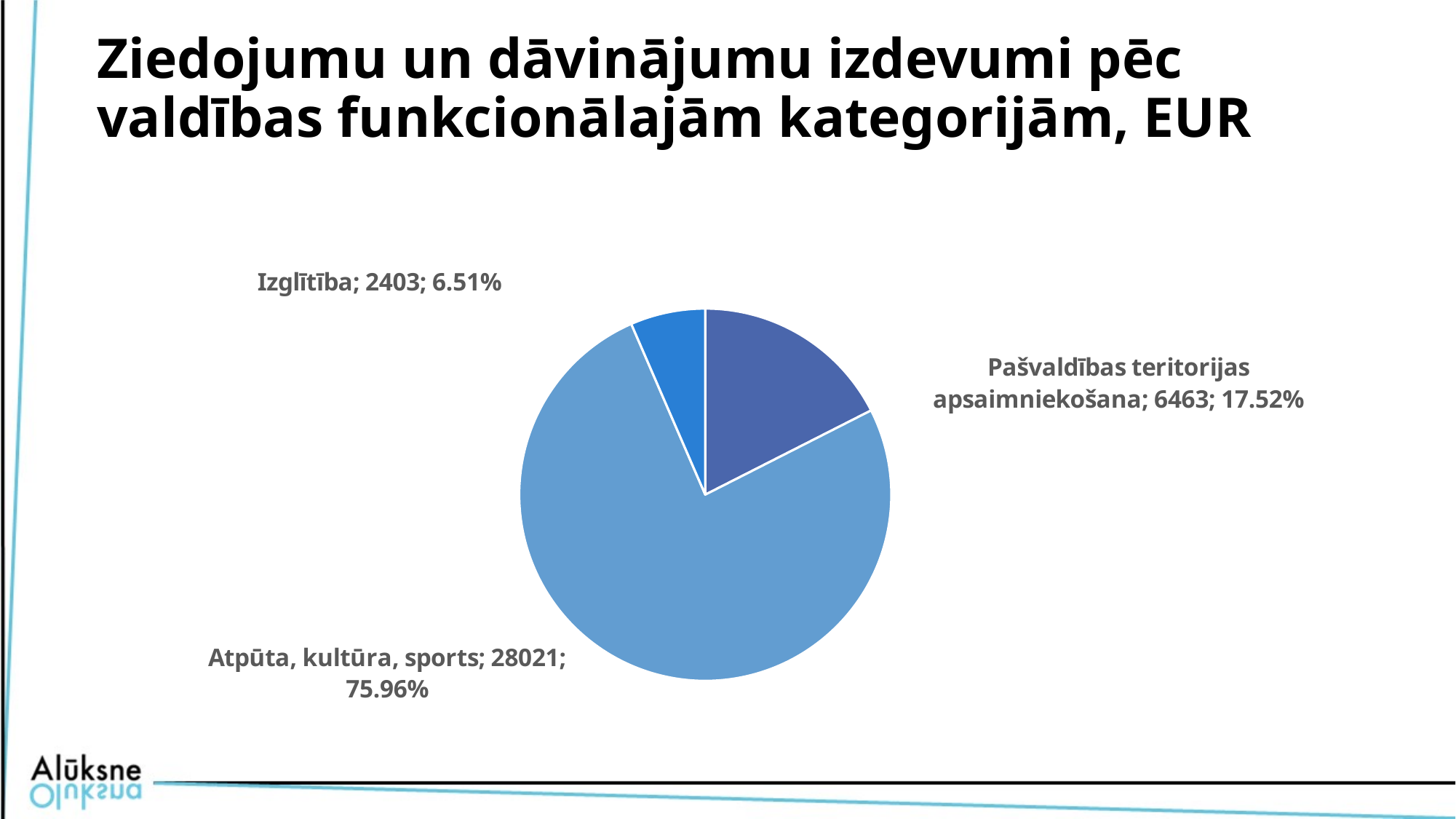
What is the title of the chart? Ziedojumu un dāvinājumu izdevumi pēc valdības funkcionālajām kategorijām, EUR What share of the pie does Atpūta, kultūra, sports represent? 75.96% What is the value for Atpūta, kultūra, sports? 28021 Which category has the smallest slice? Izglītība What is the difference between the values for Pašvaldības teritorijas apsaimniekošana and Izglītība? 4060 What kind of chart is shown on the slide? pie chart How many slices does the pie chart have? 3 What share of the pie does Izglītība represent? 6.51% What is the value for Pašvaldības teritorijas apsaimniekošana? 6463 Which category has the largest slice? Atpūta, kultūra, sports Which is larger, the value for Pašvaldības teritorijas apsaimniekošana or the value for Izglītība? Pašvaldības teritorijas apsaimniekošana What is the value for Izglītība? 2403